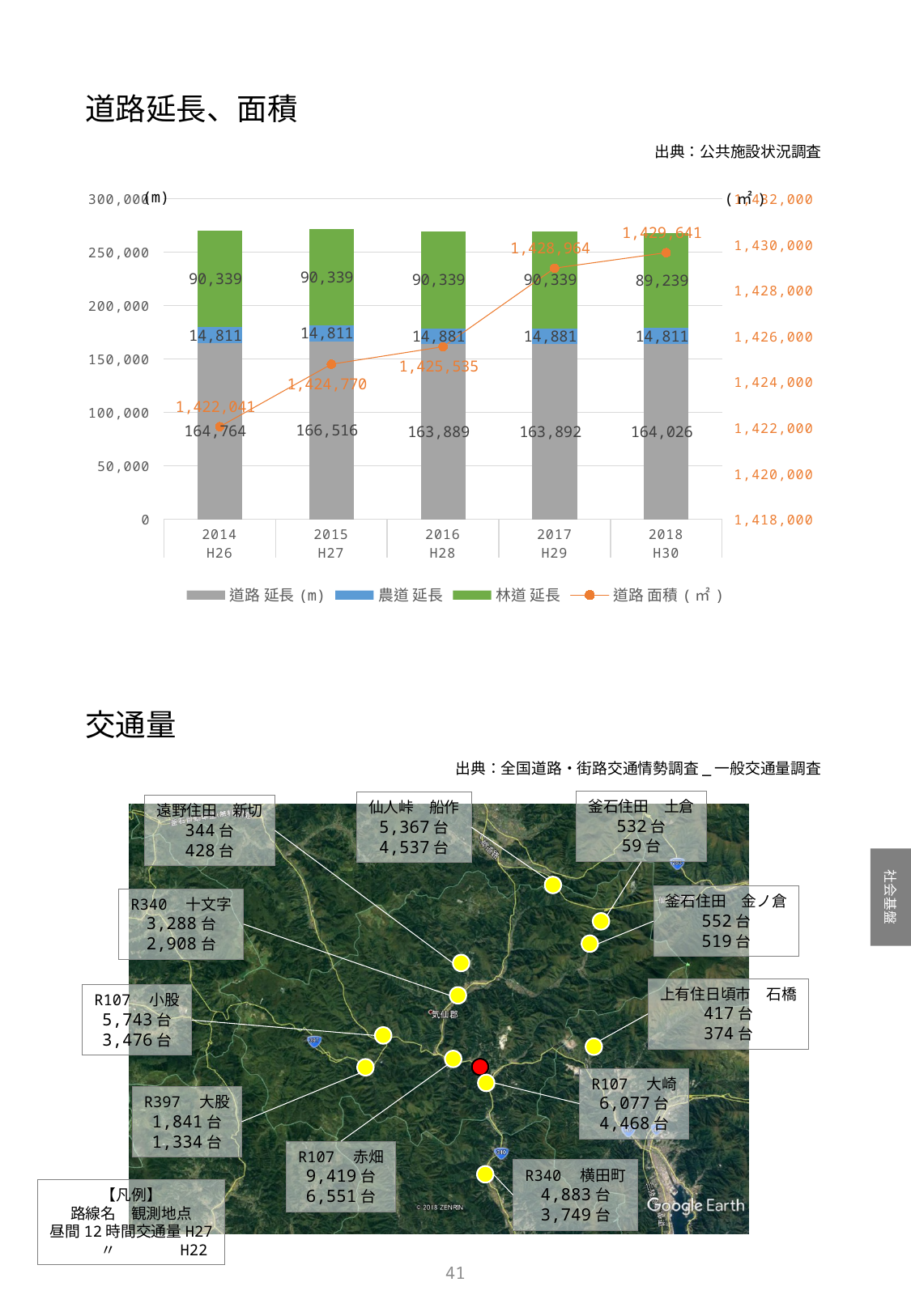
In the 道路延長、面積 chart, which year has the highest 道路 延長 (m)? 2015 (H27) In the 道路延長、面積 chart, what is the 林道 延長 value for 2018 (H30)? 89,239 In the 道路延長、面積 chart, what is the difference in 道路 面積 (㎡) between 2018 and 2014? 7,600 In the 道路延長、面積 chart, what is the value of 道路 延長 (m) for 2014 (H26)? 164,764 In the 道路延長、面積 chart, is the 農道 延長 value larger in 2016 or in 2018? 2016 In the 道路延長、面積 chart, which year has the highest 道路 面積 (㎡)? 2018 (H30) In the 道路延長、面積 chart, how many series does the legend list? 4 In the 道路延長、面積 chart, what is the 道路 面積 (㎡) value for 2018 (H30)? 1,429,641 In the 道路延長、面積 chart, which year has the lowest 道路 面積 (㎡)? 2014 (H26) In the 道路延長、面積 chart, how many years are shown on the x axis? 5 In the 道路延長、面積 chart, does the 道路 面積 (㎡) line rise or fall from 2014 to 2018? rise In the 道路延長、面積 chart, what is the total of the stacked bar for 2014 (H26)? 269,914